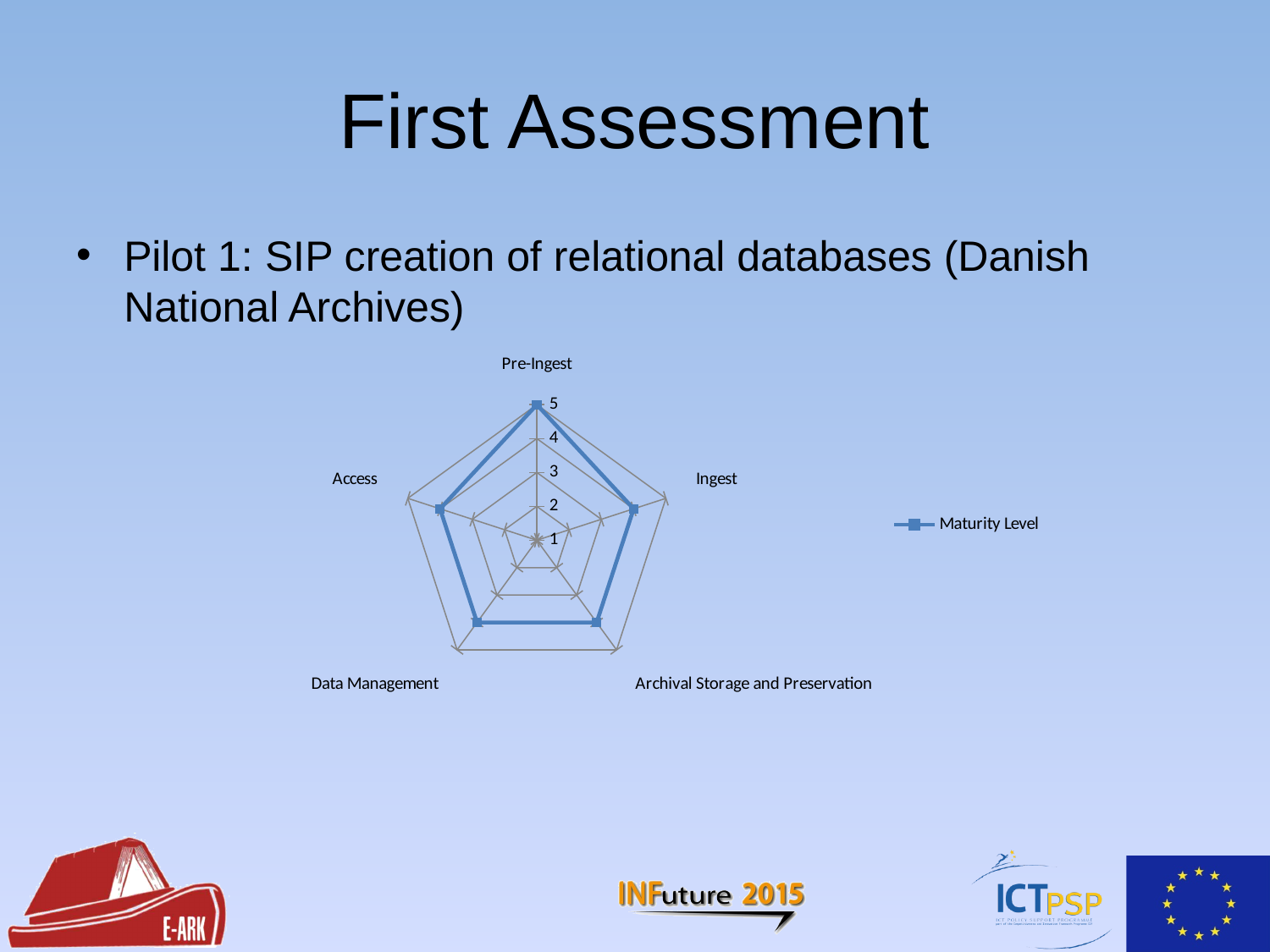
Is the Maturity Level for Access greater or less than 3? greater What is the difference between the Maturity Level for Pre-Ingest and for Ingest? 1 What is the name of the series shown in the legend of the radar chart? Maturity Level Which has a higher Maturity Level, Pre-Ingest or Access? Pre-Ingest What type of chart is shown on the slide? Radar chart Which category has the highest Maturity Level? Pre-Ingest How many categories (axes) does the radar chart have? 5 How many series does the legend of the radar chart list? 1 What is the Maturity Level value for Ingest? 4 Is the Maturity Level for Data Management greater or less than 2? greater What is the Maturity Level value for Pre-Ingest? 5 What is the highest value shown on the radar chart's axis scale? 5